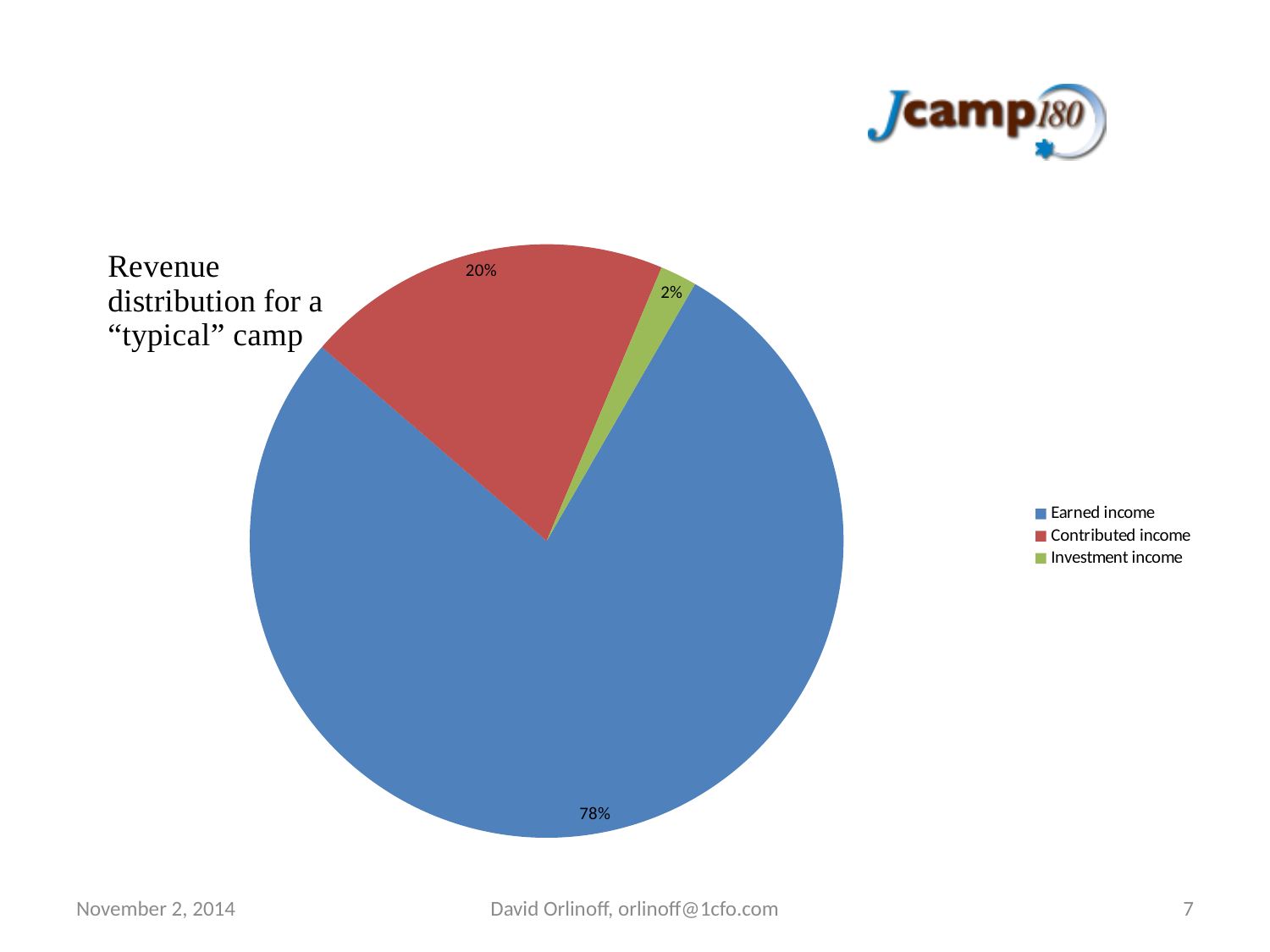
What is the title text next to the pie chart? Revenue distribution for a "typical" camp Which revenue category has the smallest share? Investment income What kind of chart is shown on the slide? pie chart What share of revenue is Earned income? 78% What share of revenue is Investment income? 2% Which is larger, Contributed income or Investment income? Contributed income What is the difference in percentage points between Contributed income and Investment income? 18 Which colour represents Contributed income in the pie chart? red What is the difference in percentage points between Earned income and Contributed income? 58 How many categories does the pie chart show? 3 Which revenue category has the largest share? Earned income What share of revenue is Contributed income? 20%